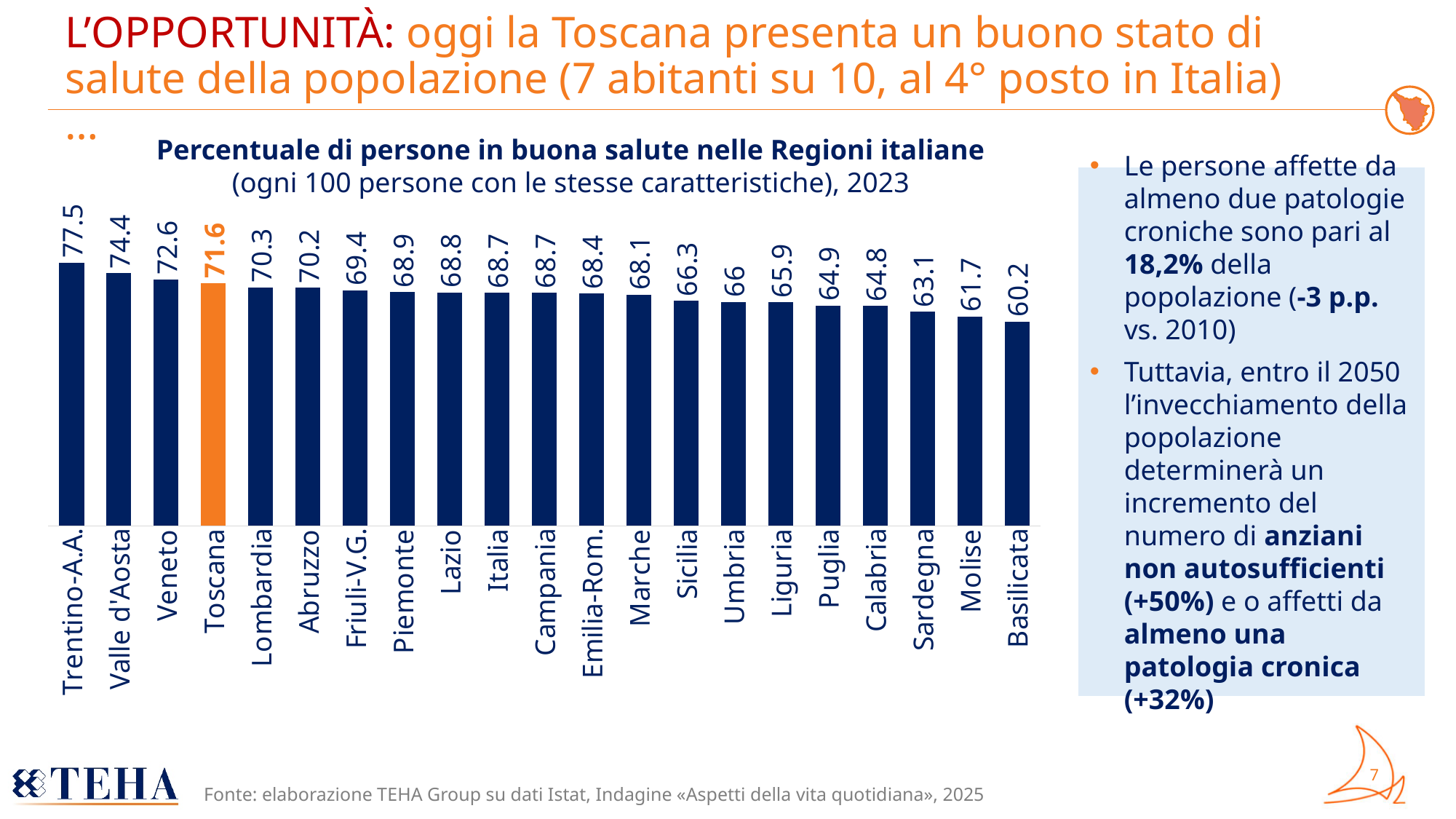
What is the difference between the values for Trentino-A.A. and Toscana? 5.9 What kind of chart is shown on the slide? Bar chart Which region has the lowest value? Basilicata What is the difference between the values for Toscana and Italia? 2.9 Which bar is highlighted in orange? Toscana What is the value for Toscana? 71.6 Which has a larger value, Veneto or Lombardia? Veneto What is the value for Italia? 68.7 What is the value for Basilicata? 60.2 How many bars are shown in the chart? 21 Which region has the highest value? Trentino-A.A. What is the value for Umbria? 66